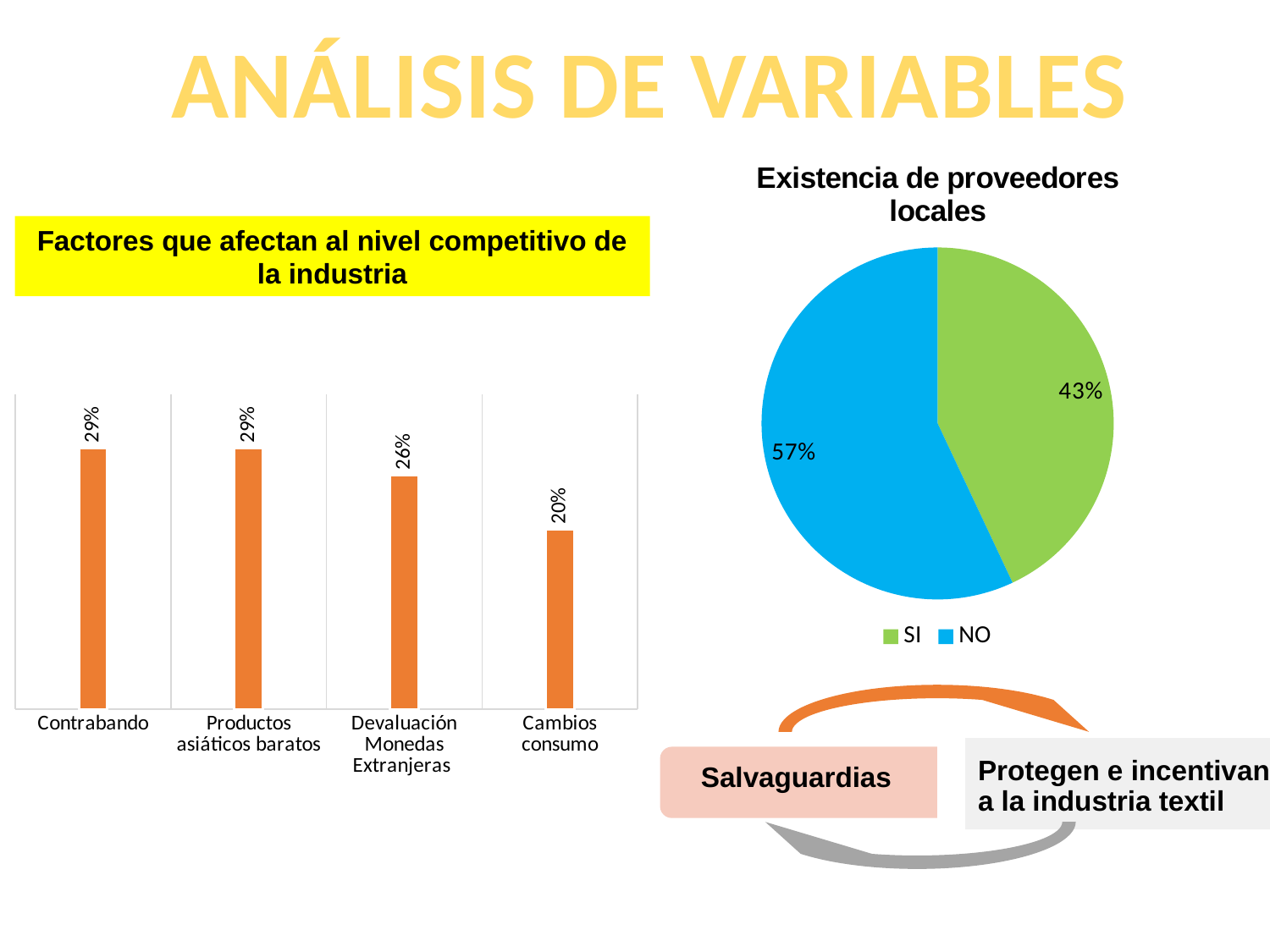
In the 'Existencia de proveedores locales' pie chart, what share is SI? 43% In the 'Factores que afectan al nivel competitivo de la industria' chart, do the values rise or fall from left to right? Fall In the 'Factores que afectan al nivel competitivo de la industria' chart, what is the value for Devaluación Monedas Extranjeras? 26% In the 'Factores que afectan al nivel competitivo de la industria' chart, what is the value for Cambios consumo? 20% In the 'Existencia de proveedores locales' pie chart, what share is NO? 57% What kind of chart is 'Existencia de proveedores locales'? Pie chart In the 'Factores que afectan al nivel competitivo de la industria' chart, which is larger: Productos asiáticos baratos or Devaluación Monedas Extranjeras? Productos asiáticos baratos What kind of chart is 'Factores que afectan al nivel competitivo de la industria'? Bar chart How many categories are shown in the 'Factores que afectan al nivel competitivo de la industria' chart? 4 In the 'Factores que afectan al nivel competitivo de la industria' chart, what is the difference between Contrabando and Cambios consumo? 9% In the 'Factores que afectan al nivel competitivo de la industria' chart, what is the value for Contrabando? 29% In the 'Factores que afectan al nivel competitivo de la industria' chart, which category has the lowest value? Cambios consumo